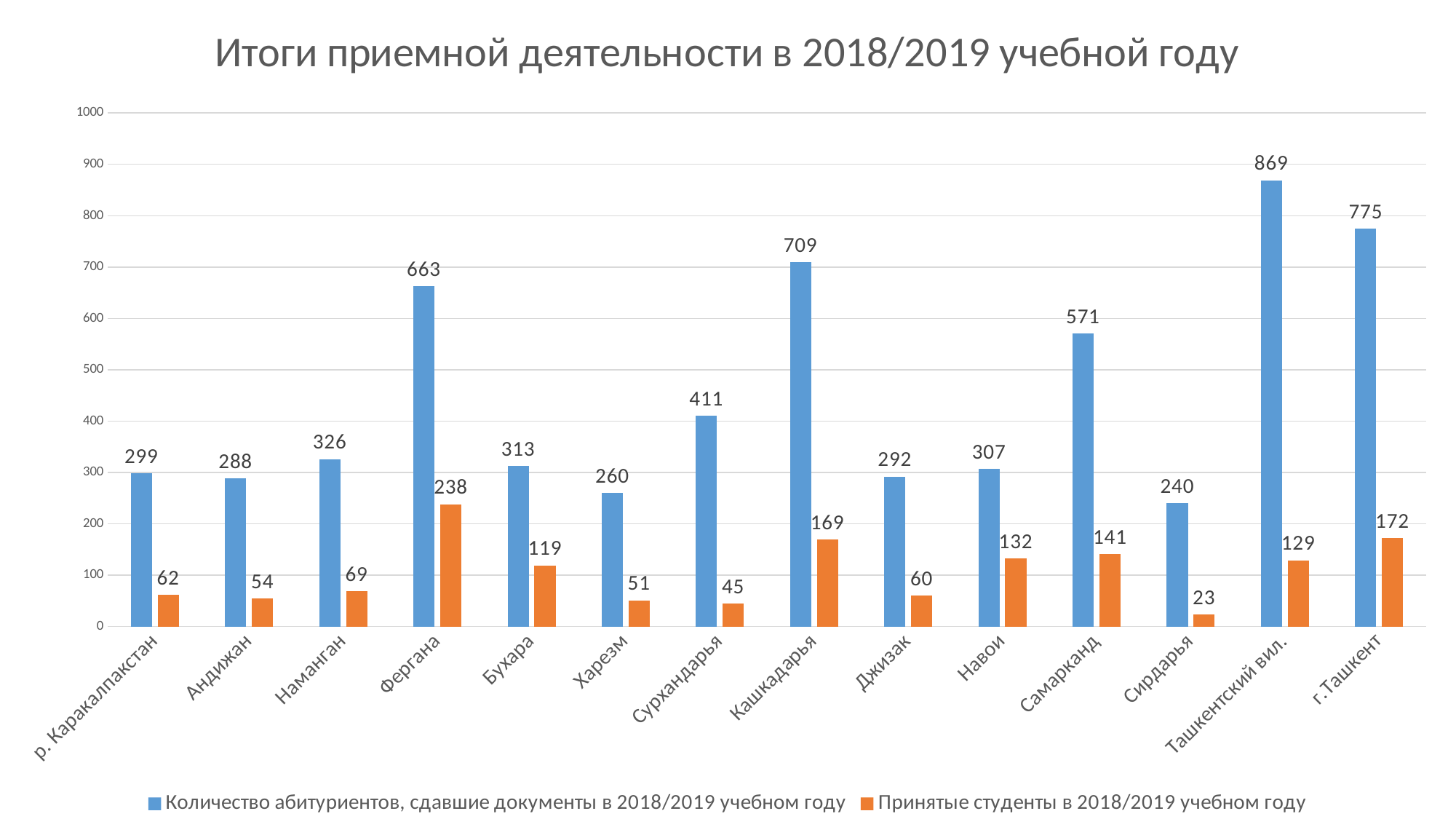
How many admitted students (Принятые студенты) are shown for Самарканд? 141 What type of chart is shown on the slide? Bar chart Which region has the highest number of applicants who submitted documents? Ташкентский вил. What is the title of the chart? Итоги приемной деятельности в 2018/2019 учебной году Is the number of applicants who submitted documents for г.Ташкент greater or less than 700? greater Which colour represents the admitted students (Принятые студенты) series? Orange How many series does the legend list? 2 What is the difference between applicants who submitted documents and admitted students for Кашкадарья? 540 How many regions are shown on the x axis? 14 Which has more admitted students, Бухара or Навои? Навои What is the number of applicants who submitted documents (Количество абитуриентов, сдавшие документы) for Фергана? 663 Which region has the lowest number of admitted students? Сирдарья